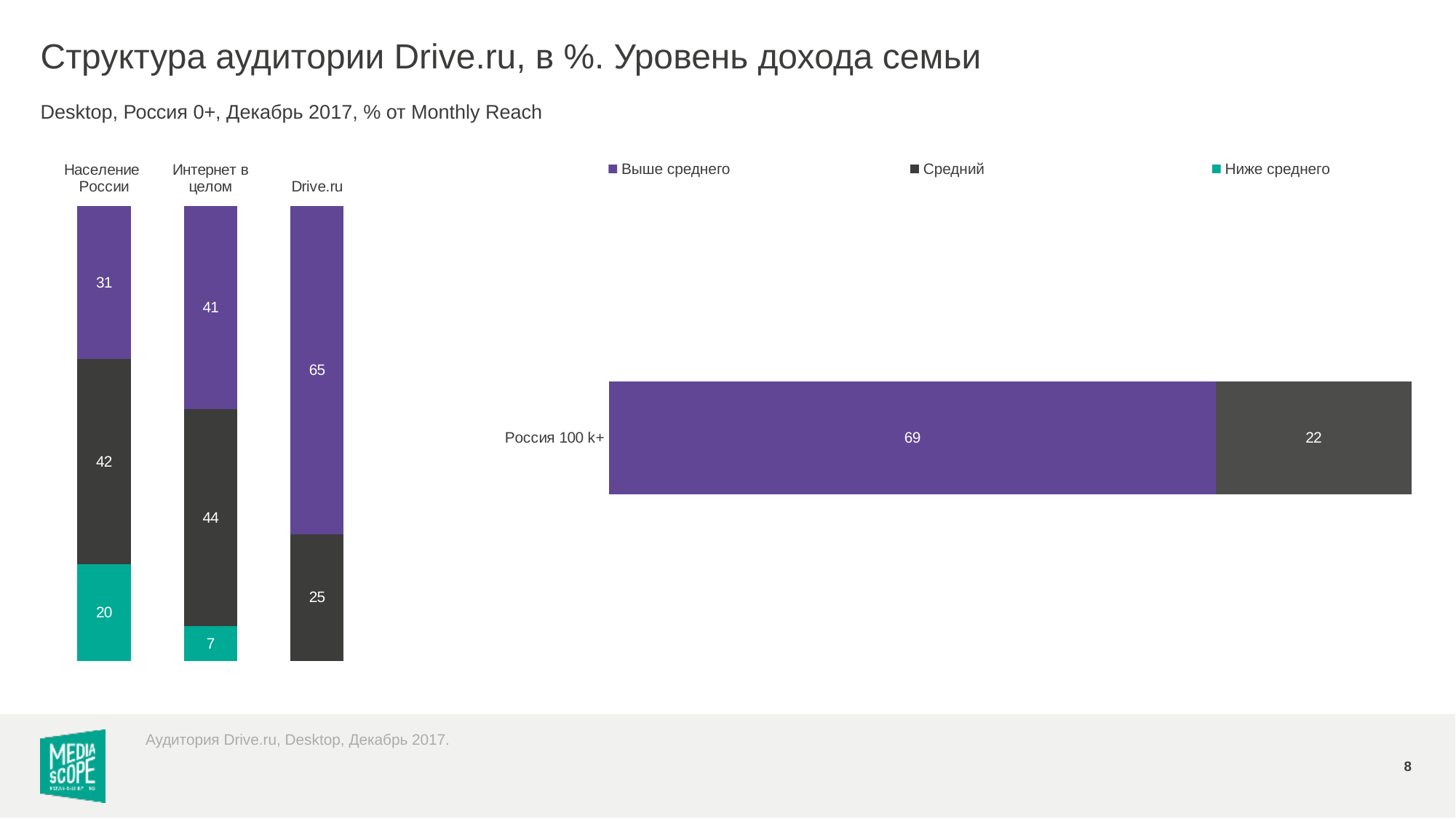
In the left chart, what is the value for Ниже среднего for Интернет в целом? 7 In the left chart, which is larger: the Ниже среднего value for Население России or for Интернет в целом? Население России In the left chart, which category has the highest value for Выше среднего? Drive.ru In the right chart, what is the value for Выше среднего for Россия 100 k+? 69 What kind of chart is the right chart? Stacked bar chart In the left chart, what is the value for Средний for Население России? 42 How many series does the legend list? 3 In the left chart, what is the value for Выше среднего for Drive.ru? 65 In the left chart, which category has the lowest value for Средний? Drive.ru In the left chart, what is the difference between the Выше среднего values for Drive.ru and Население России? 34 How many categories are shown in the left chart? 3 In the right chart, what is the value for Средний for Россия 100 k+? 22